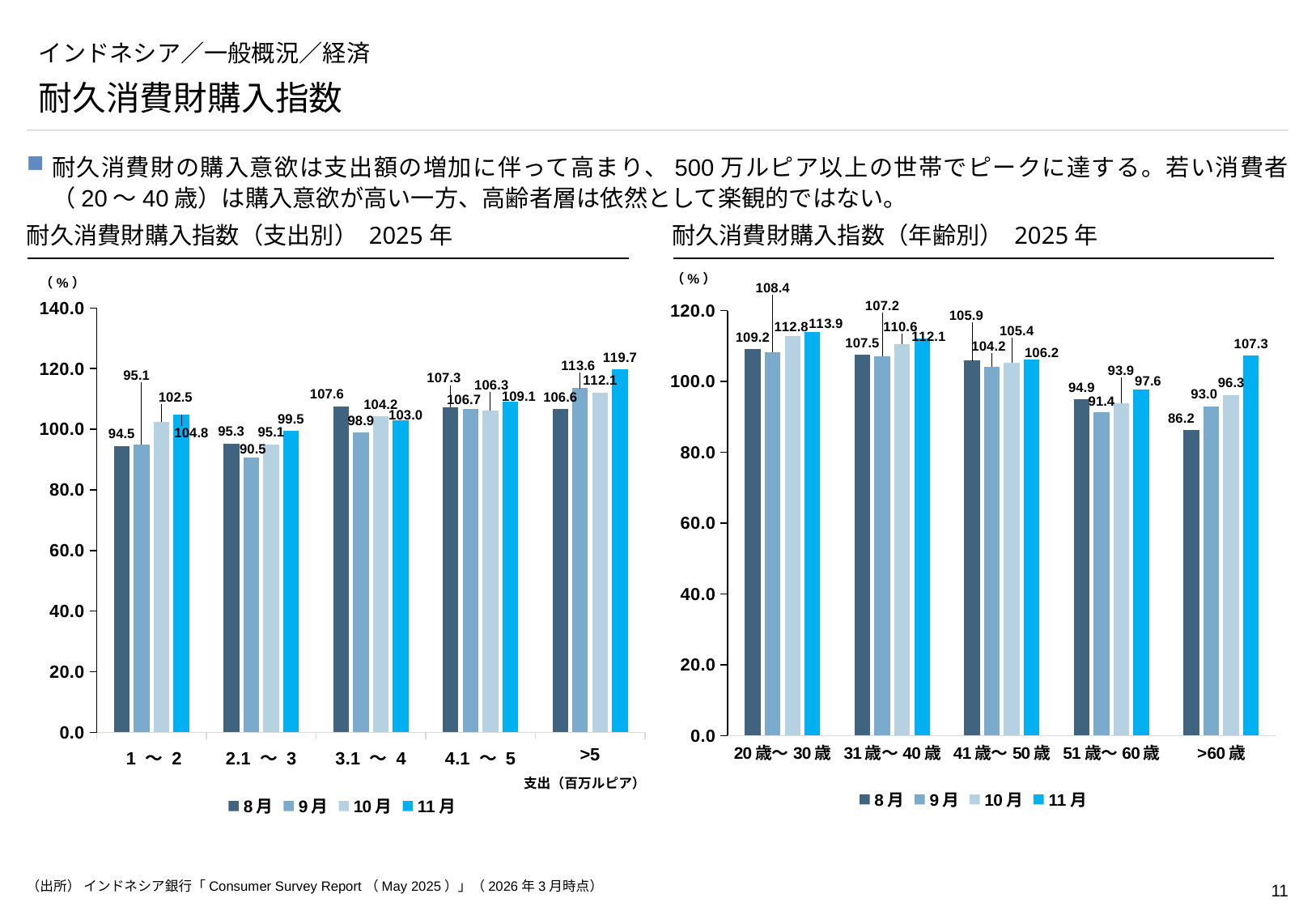
「耐久消費財購入指数（年齢別） 2025年」のグラフで、「>60歳」の8月の値はいくつですか？ 86.2 「耐久消費財購入指数（年齢別） 2025年」のグラフで、「31歳～40歳」の10月の値はいくつですか？ 110.6 「耐久消費財購入指数（年齢別） 2025年」のグラフで、「>60歳」の11月と8月の値の差はいくつですか？ 21.1 「耐久消費財購入指数（支出別） 2025年」のグラフで、11月の値が最も高い支出区分はどれですか？ >5 「耐久消費財購入指数（支出別） 2025年」のグラフで、支出「>5」の11月と8月の値の差はいくつですか？ 13.1 「耐久消費財購入指数（支出別） 2025年」のグラフで、支出「2.1～3」の9月の値はいくつですか？ 90.5 「耐久消費財購入指数（年齢別） 2025年」のグラフで、「20歳～30歳」の11月と「51歳～60歳」の11月では、どちらの値が大きいですか？ 20歳～30歳 「耐久消費財購入指数（年齢別） 2025年」のグラフで、8月の値が最も低い年齢区分はどれですか？ >60歳 「耐久消費財購入指数（支出別） 2025年」のグラフで、支出「>5」の11月の値はいくつですか？ 119.7 「耐久消費財購入指数（支出別） 2025年」のグラフは、どの種類のグラフですか？ 棒グラフ 「耐久消費財購入指数（年齢別） 2025年」のグラフには、年齢区分がいくつありますか？ 5 「耐久消費財購入指数（支出別） 2025年」のグラフで、凡例にはいくつの系列がありますか？ 4